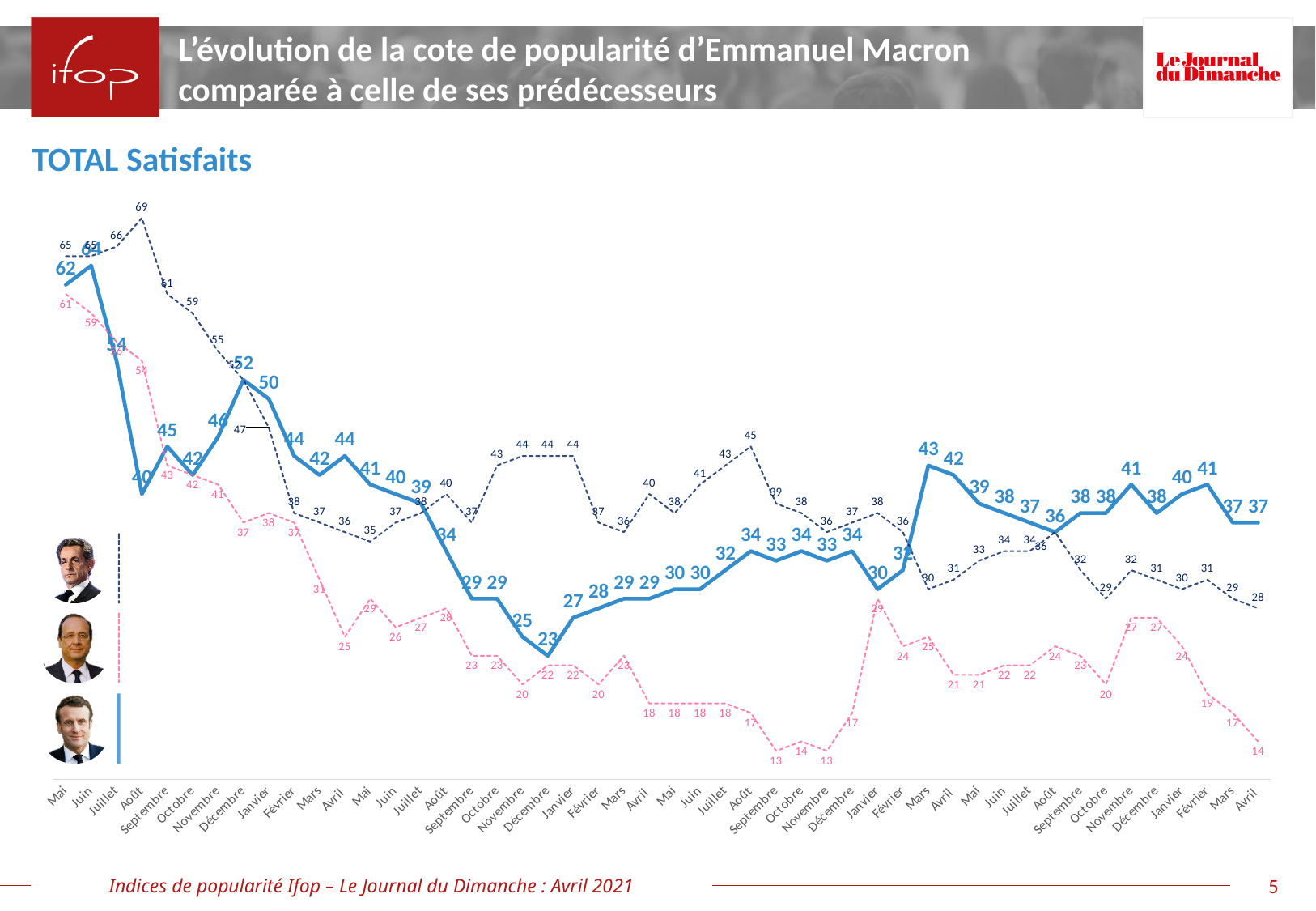
What is the highest value reached by the solid blue line (Emmanuel Macron)? 64 How many lines (series) are plotted on the chart? 3 What is the first value of the solid blue line (Emmanuel Macron), at the first Mai on the x axis? 62 What is the highest value shown on the whole chart, reached by the dark dashed line? 69 At the final Avril on the x axis, which line has the larger value: the solid blue line (37) or the dark dashed line (28)? the solid blue line Overall, does the solid blue line rise or fall from the first Mai to the final Avril? fall What is the title shown above the chart? TOTAL Satisfaits What is the last value of the solid blue line (Emmanuel Macron), at the final Avril on the x axis? 37 What is the lowest value shown on the whole chart, reached by the pink dashed line? 13 What is the lowest value reached by the solid blue line (Emmanuel Macron)? 23 What is the difference between the first value (62) and the last value (37) of the solid blue line? 25 What kind of chart is shown on the slide? line chart